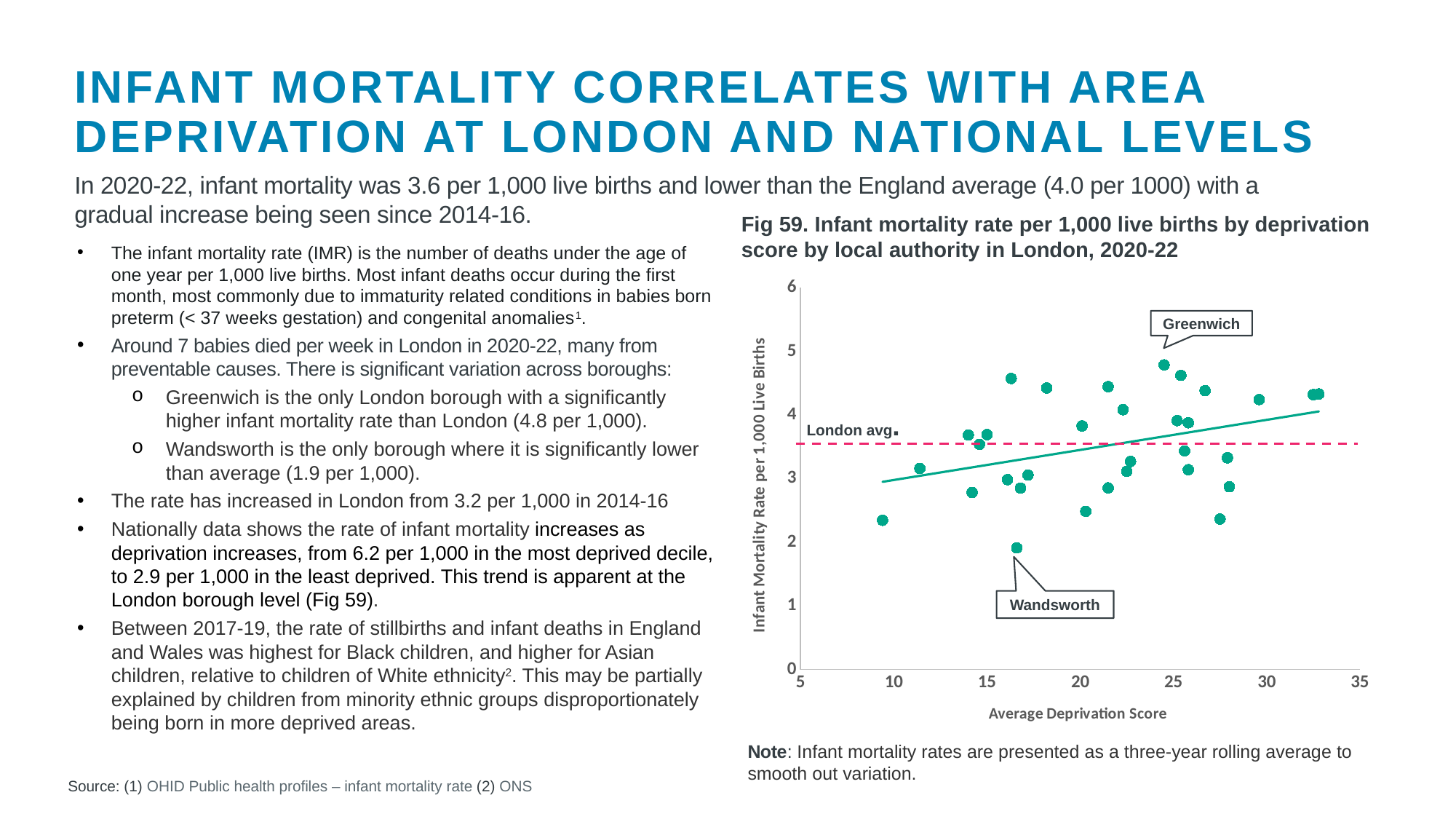
Which labelled borough has the lowest infant mortality rate on the chart? Wandsworth What is the highest value shown on the y axis of the chart? 6 Which has the higher infant mortality rate on the chart, Greenwich or Wandsworth? Greenwich What is the label of the x axis of the chart? Average Deprivation Score Is the infant mortality rate for Wandsworth greater or less than 2? less Is the London average line on the chart greater or less than 3? greater Is the infant mortality rate for Greenwich greater or less than 4? greater What kind of chart is Fig 59? scatter chart What is the title of the chart on the slide? Fig 59. Infant mortality rate per 1,000 live births by deprivation score by local authority in London, 2020-22 Does the trend line show infant mortality rising or falling as the average deprivation score increases? rising What is the highest value shown on the x axis of the chart? 35